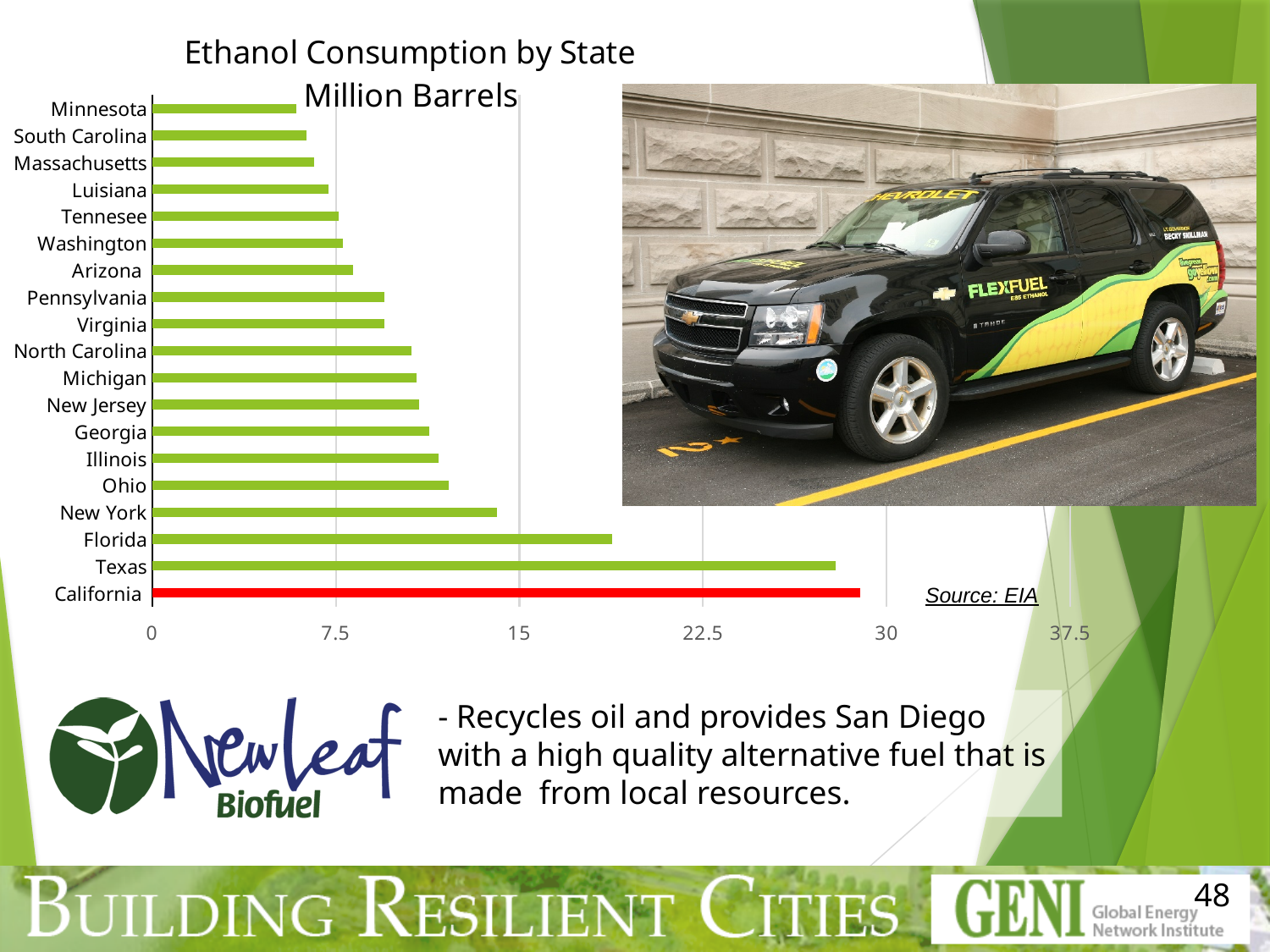
Is the value for Minnesota greater or less than 7.5? less Is the value for Ohio greater or less than 7.5? greater Which state has the highest ethanol consumption in the chart? California Which state has a larger value, Florida or New York? Florida What is the title of the chart? Ethanol Consumption by State Million Barrels How many states are shown in the chart? 19 Is the value for Florida greater or less than 15? greater What kind of chart is shown on the slide? bar chart Which bar in the chart is coloured red instead of green? California Which state has the lowest ethanol consumption in the chart? Minnesota